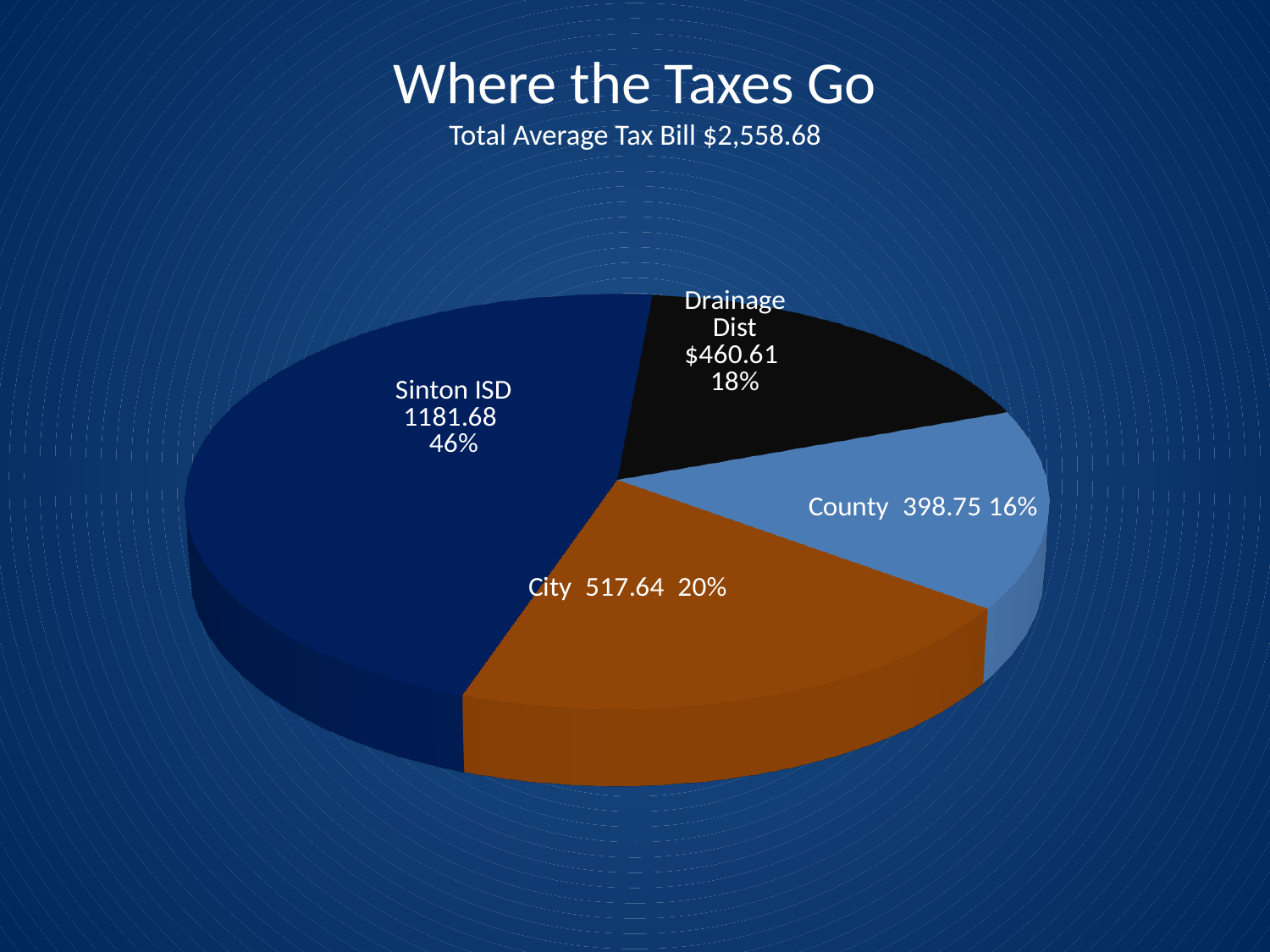
What share of the pie does Drainage Dist represent? 18% What kind of chart is shown on the slide? pie chart What is the value shown for Drainage Dist? $460.61 How many slices does the pie chart have? 4 Which category has the smallest slice of the pie? County What is the value shown for City? 517.64 What is the value shown for County? 398.75 Which is larger, the value for City or the value for County? City Which category has the largest slice of the pie? Sinton ISD What share of the pie does City represent? 20% What is the title of the chart? Where the Taxes Go What is the value shown for Sinton ISD? 1181.68